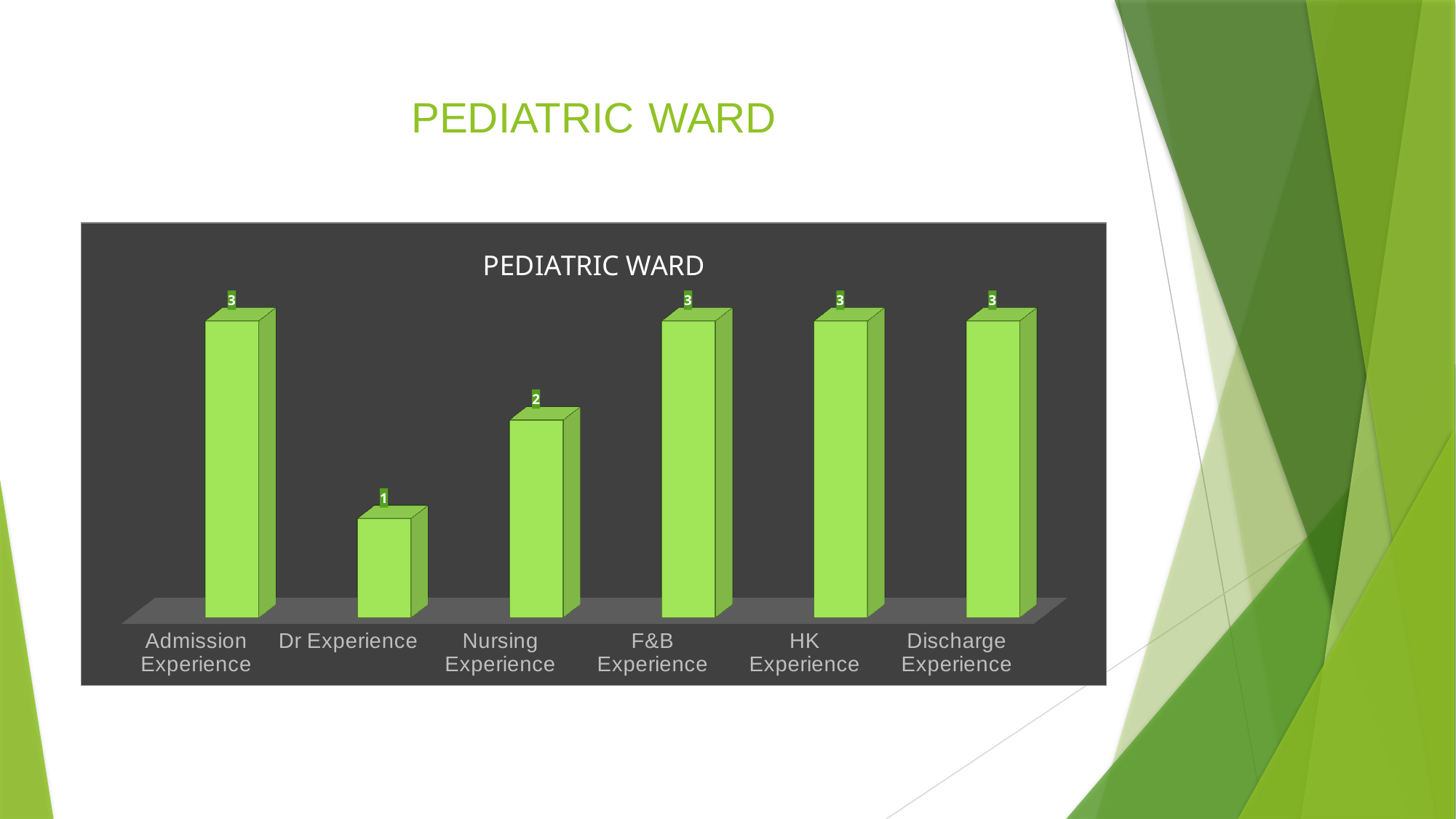
What is the difference between the values for Nursing Experience and Dr Experience? 1 What is the title of the chart? PEDIATRIC WARD Which is larger, the value for Nursing Experience or the value for F&B Experience? F&B Experience How many categories have a value of 3? 4 What is the value for Dr Experience? 1 How many categories are shown in the chart? 6 What is the value for HK Experience? 3 What kind of chart is shown on the slide? Bar chart What is the value for Admission Experience? 3 What is the difference between the values for Admission Experience and Dr Experience? 2 What is the value for Nursing Experience? 2 Which category has the lowest value? Dr Experience